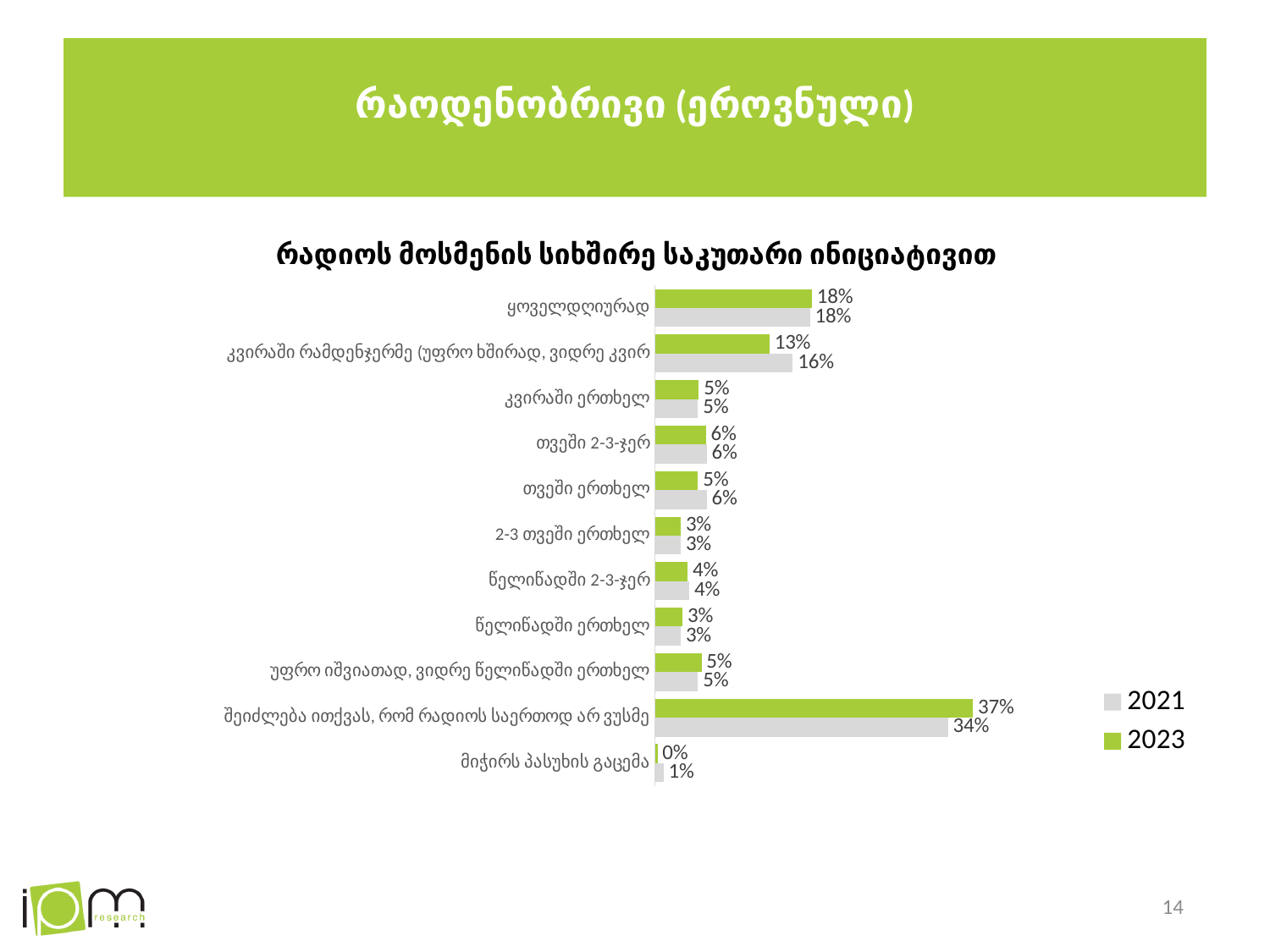
How many series does the legend list? 2 What is the 2021 value for "კვირაში რამდენჯერმე (უფრო ხშირად, ვიდრე კვირ"? 16% What is the difference between the 2021 and 2023 values for "კვირაში რამდენჯერმე (უფრო ხშირად, ვიდრე კვირ"? 3% What kind of chart is shown on the slide? Bar chart What is the 2021 value for "მიჭირს პასუხის გაცემა"? 1% What is the difference between the 2023 and 2021 values for "შეიძლება ითქვას, რომ რადიოს საერთოდ არ ვუსმენ"? 3% What is the 2023 value for "ყოველდღიურად"? 18% Which category has the lowest 2023 value? მიჭირს პასუხის გაცემა How many categories are shown in the chart? 11 What is the 2023 value for "შეიძლება ითქვას, რომ რადიოს საერთოდ არ ვუსმენ"? 37% Which category has the highest 2023 value? შეიძლება ითქვას, რომ რადიოს საერთოდ არ ვუსმენ For "თვეში ერთხელ", which year has the larger value, 2021 or 2023? 2021